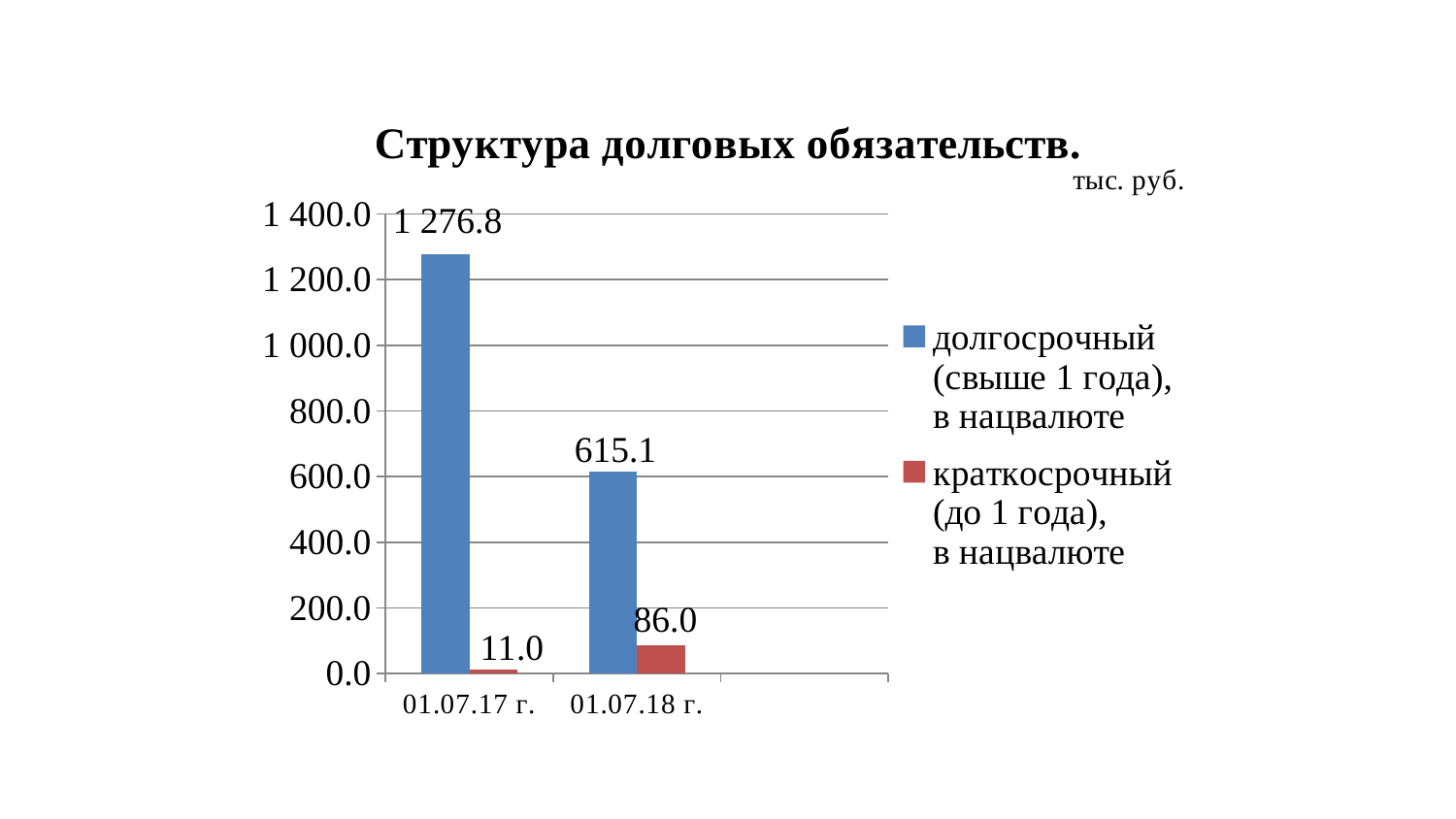
How many series does the legend list? 2 What is the difference between the краткосрочный values for 01.07.18 г. and 01.07.17 г.? 75.0 Which date has the lowest value for the краткосрочный (до 1 года), в нацвалюте series? 01.07.17 г. Which is larger: the долгосрочный value for 01.07.18 г. or the краткосрочный value for 01.07.18 г.? долгосрочный value for 01.07.18 г. What is the value of the краткосрочный (до 1 года), в нацвалюте series for 01.07.17 г.? 11.0 What kind of chart is shown on the slide? bar chart What is the value of the долгосрочный (свыше 1 года), в нацвалюте series for 01.07.18 г.? 615.1 What is the value of the долгосрочный (свыше 1 года), в нацвалюте series for 01.07.17 г.? 1 276.8 Which date has the highest value for the долгосрочный (свыше 1 года), в нацвалюте series? 01.07.17 г. How many dates (categories) are shown on the x axis? 2 What is the difference between the долгосрочный values for 01.07.17 г. and 01.07.18 г.? 661.7 What is the value of the краткосрочный (до 1 года), в нацвалюте series for 01.07.18 г.? 86.0